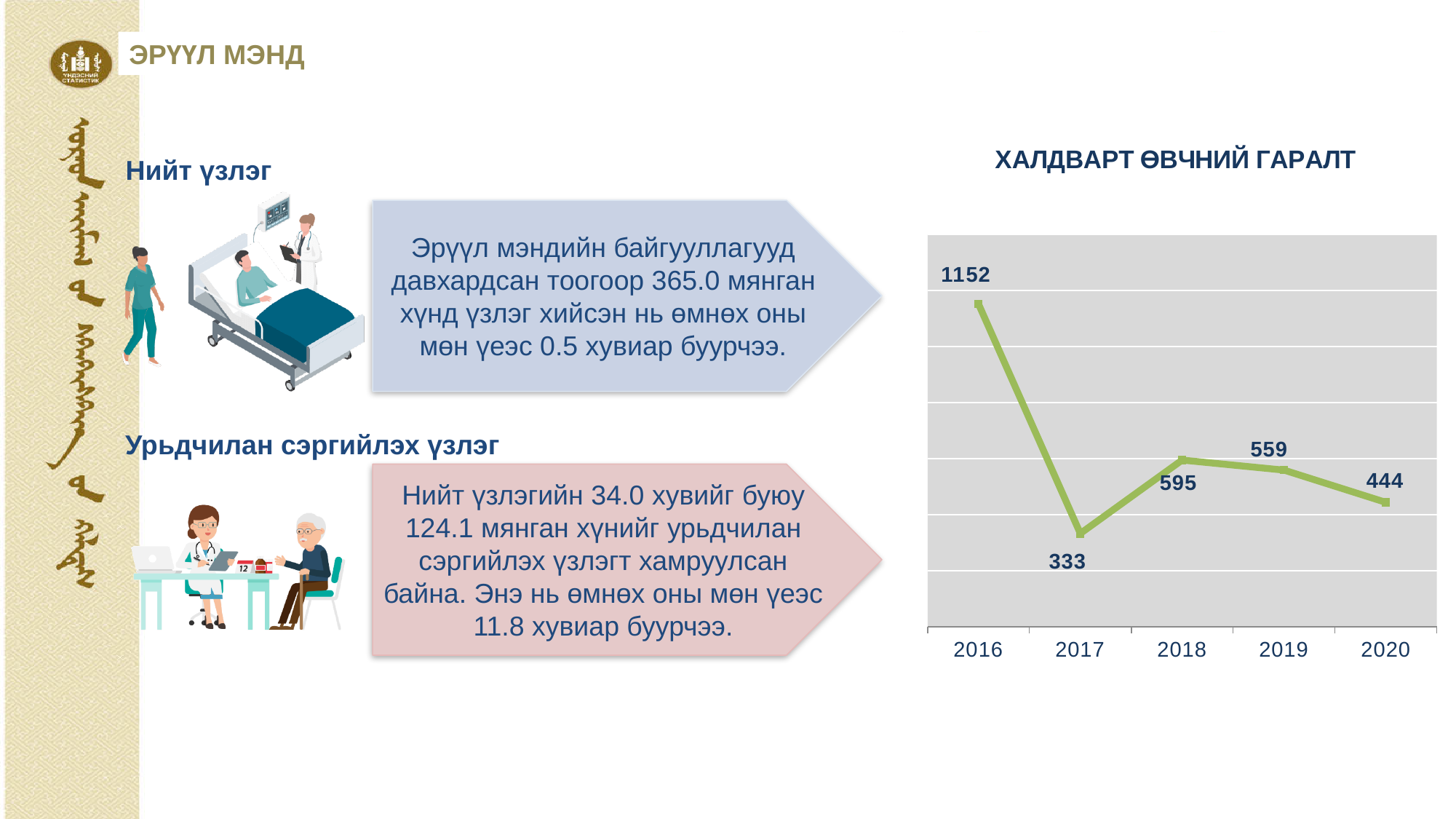
In the ХАЛДВАРТ ӨВЧНИЙ ГАРАЛТ chart, what is the difference between the 2016 and 2017 values? 819 In the ХАЛДВАРТ ӨВЧНИЙ ГАРАЛТ chart, does the value rise or fall from 2018 to 2020? Fall Which year has the highest value in the ХАЛДВАРТ ӨВЧНИЙ ГАРАЛТ chart? 2016 In the ХАЛДВАРТ ӨВЧНИЙ ГАРАЛТ chart, what is the difference between the 2018 and 2019 values? 36 What is the value for 2020 in the ХАЛДВАРТ ӨВЧНИЙ ГАРАЛТ chart? 444 What type of chart is shown under the title ХАЛДВАРТ ӨВЧНИЙ ГАРАЛТ? Line chart Which year has the lowest value in the ХАЛДВАРТ ӨВЧНИЙ ГАРАЛТ chart? 2017 What is the value for 2016 in the ХАЛДВАРТ ӨВЧНИЙ ГАРАЛТ chart? 1152 What is the value for 2018 in the ХАЛДВАРТ ӨВЧНИЙ ГАРАЛТ chart? 595 In the ХАЛДВАРТ ӨВЧНИЙ ГАРАЛТ chart, which year has the larger value, 2019 or 2020? 2019 How many years are plotted in the ХАЛДВАРТ ӨВЧНИЙ ГАРАЛТ chart? 5 What is the value for 2017 in the ХАЛДВАРТ ӨВЧНИЙ ГАРАЛТ chart? 333